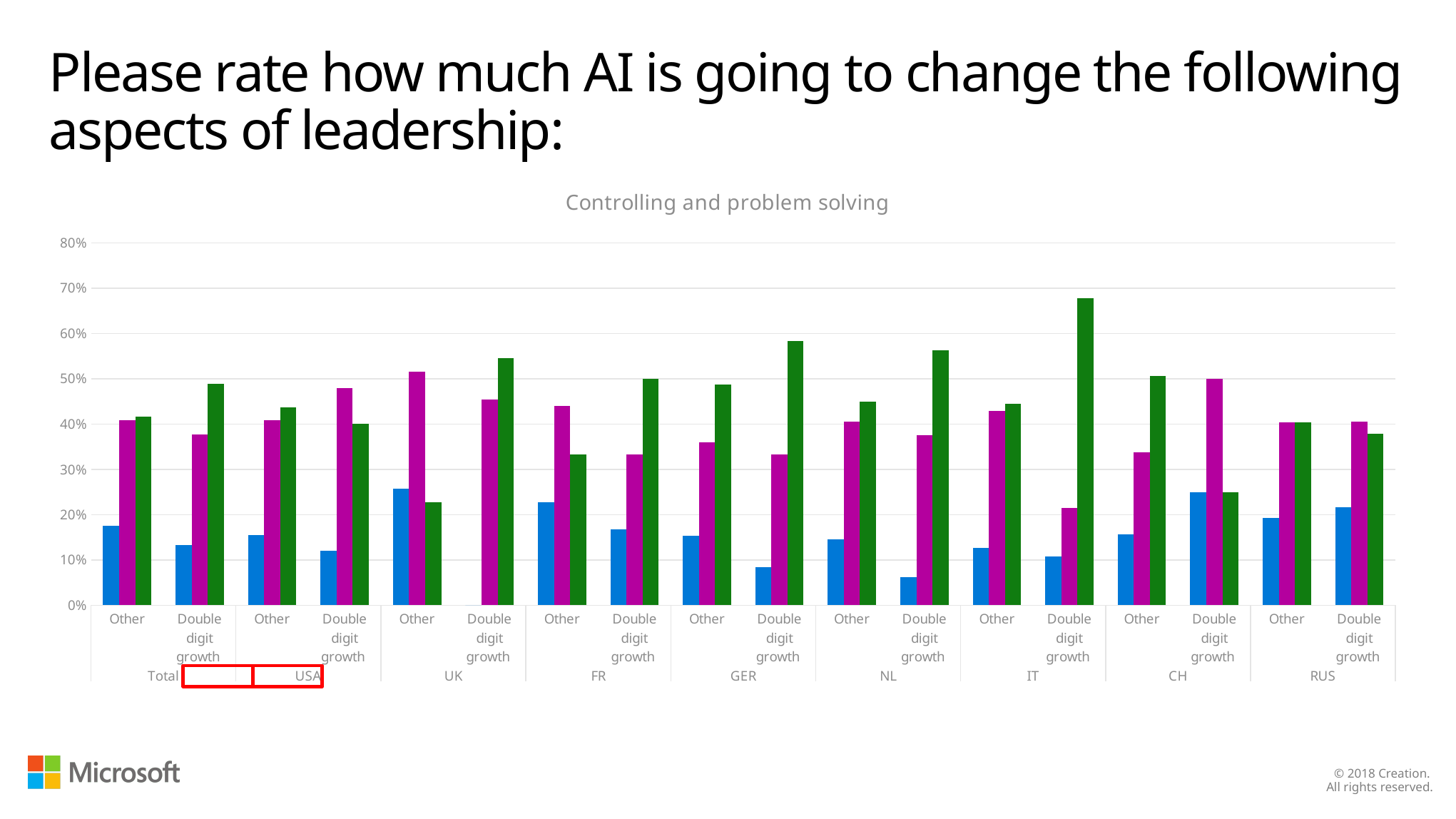
What kind of chart is shown on the slide? bar chart Is the green bar for Double digit growth in IT greater or less than 60%? greater Is the green bar for Other in UK greater or less than 30%? less What is the title of the chart? Controlling and problem solving Is the blue bar for Other in Total greater or less than 20%? less For Double digit growth in Total, which bar is taller, the green bar or the magenta bar? green For Other in UK, which bar is taller, the magenta bar or the green bar? magenta How many country/region groups are shown along the x axis of the chart? 9 Which category has the tallest bar in the chart? Double digit growth (IT)